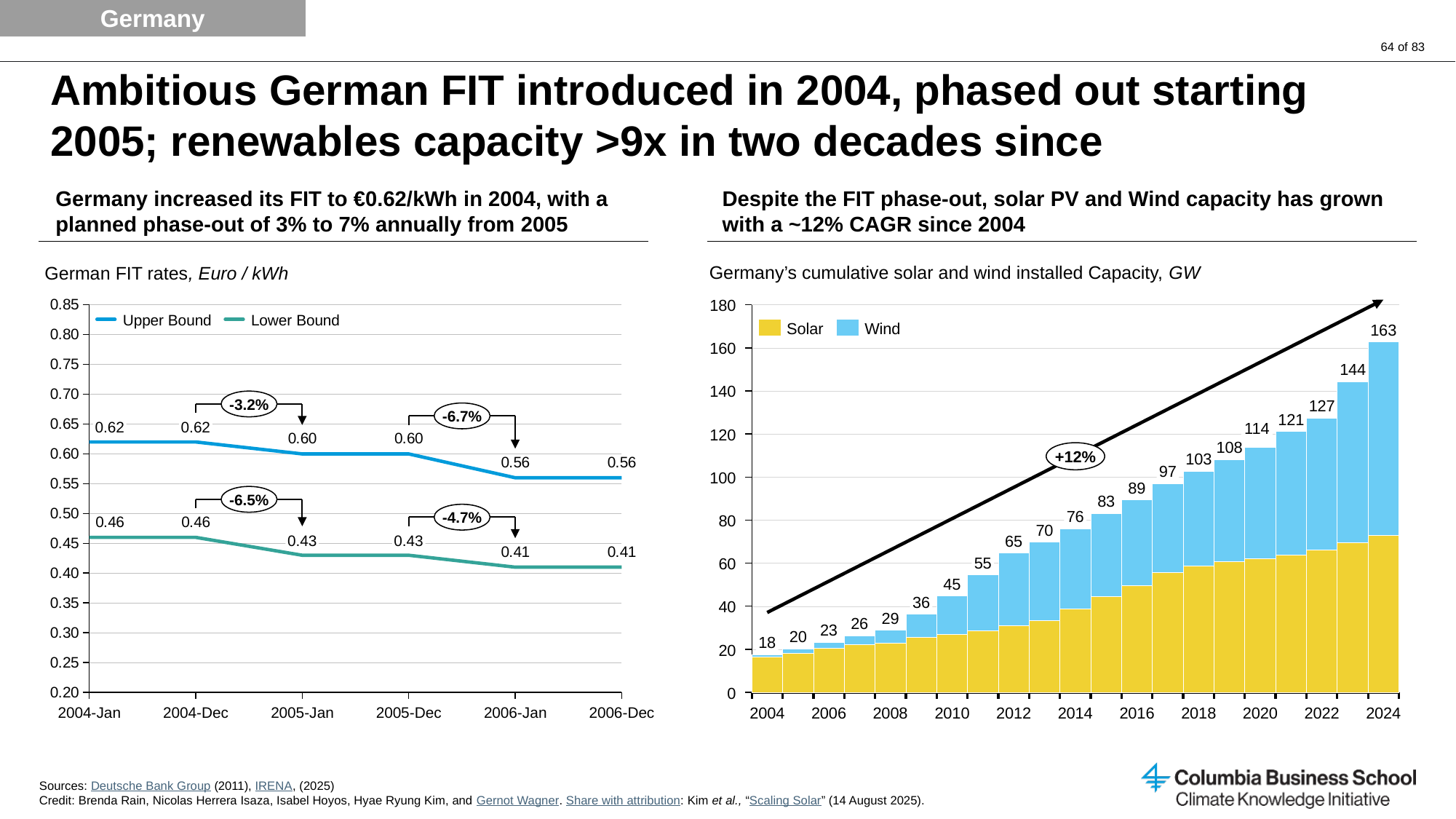
In the German FIT rates chart, does the Upper Bound rise or fall from 2004-Jan to 2006-Dec? Fall In the German FIT rates chart, what is the Upper Bound value at 2004-Jan? 0.62 In the cumulative solar and wind installed capacity chart, what is the difference in total capacity between 2024 and 2004? 145 What kind of chart is the cumulative solar and wind installed capacity chart? Stacked bar chart In the German FIT rates chart, what is the difference between the Upper Bound and Lower Bound values at 2005-Jan? 0.17 What kind of chart is the German FIT rates chart? Line chart In the cumulative solar and wind installed capacity chart, which year has the lowest total capacity? 2004 In the German FIT rates chart, what is the Lower Bound value at 2006-Dec? 0.41 In the cumulative solar and wind installed capacity chart, is the Solar value for 2024 greater or less than 60? greater In the cumulative solar and wind installed capacity chart, what is the total capacity in 2024? 163 In the German FIT rates chart, how many series does the legend list? 2 In the German FIT rates chart, what percentage change is annotated on the Upper Bound between 2005-Dec and 2006-Jan? -6.7%